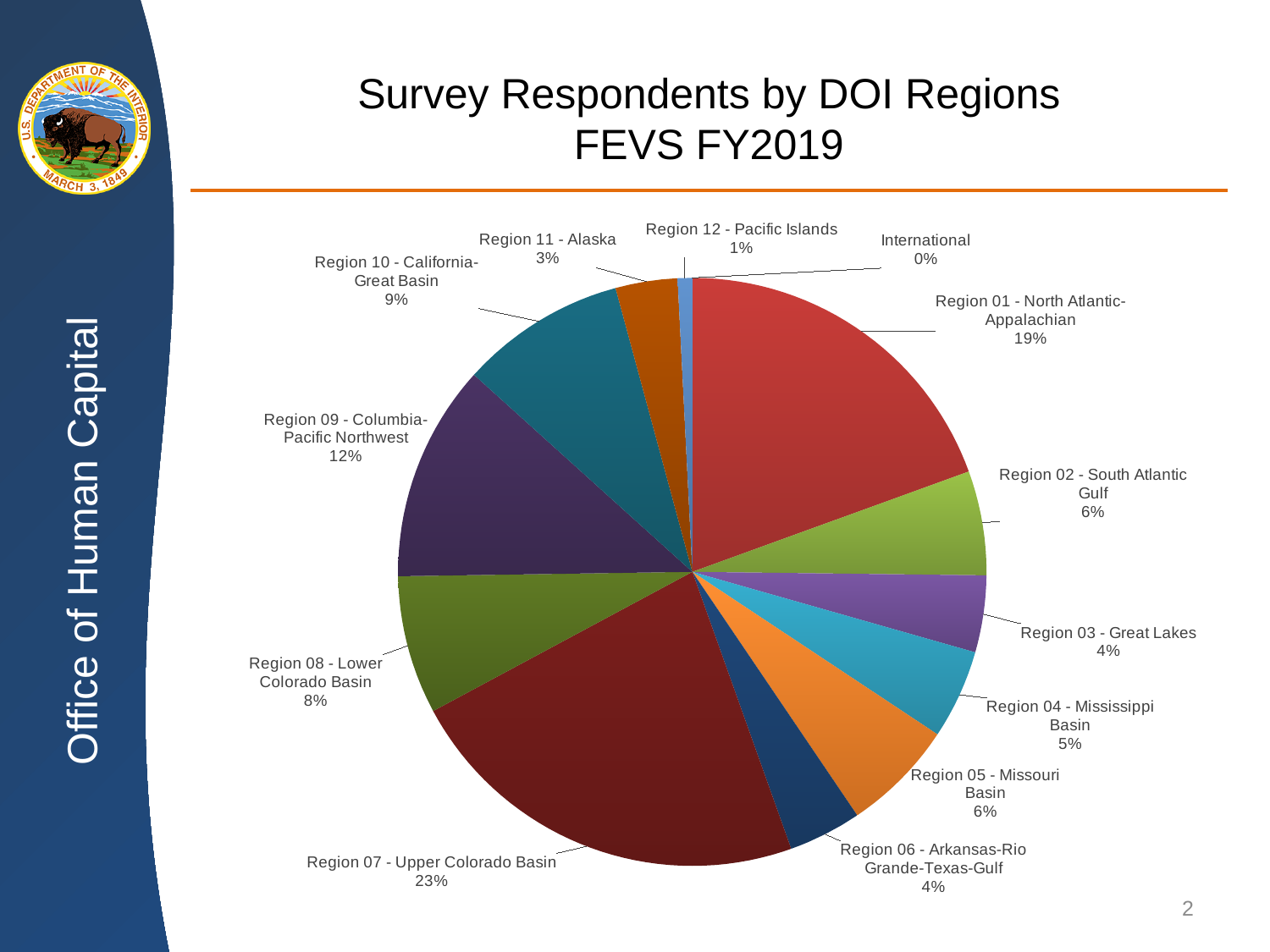
What kind of chart is shown on the slide? Pie chart What is the difference in percentage points between Region 07 - Upper Colorado Basin and Region 01 - North Atlantic-Appalachian? 4 percentage points How many categories (slices) does the pie chart have? 13 Which has a larger share, Region 10 - California-Great Basin or Region 08 - Lower Colorado Basin? Region 10 - California-Great Basin Which category has the smallest share of survey respondents? International What is the title of the chart? Survey Respondents by DOI Regions FEVS FY2019 What is the combined share of Region 02 - South Atlantic Gulf and Region 05 - Missouri Basin? 12% What percentage is shown for Region 09 - Columbia-Pacific Northwest? 12% What percentage is shown for Region 11 - Alaska? 3% What share of survey respondents is from Region 07 - Upper Colorado Basin? 23% What share of survey respondents is from Region 01 - North Atlantic-Appalachian? 19% Which region has the largest share of survey respondents? Region 07 - Upper Colorado Basin